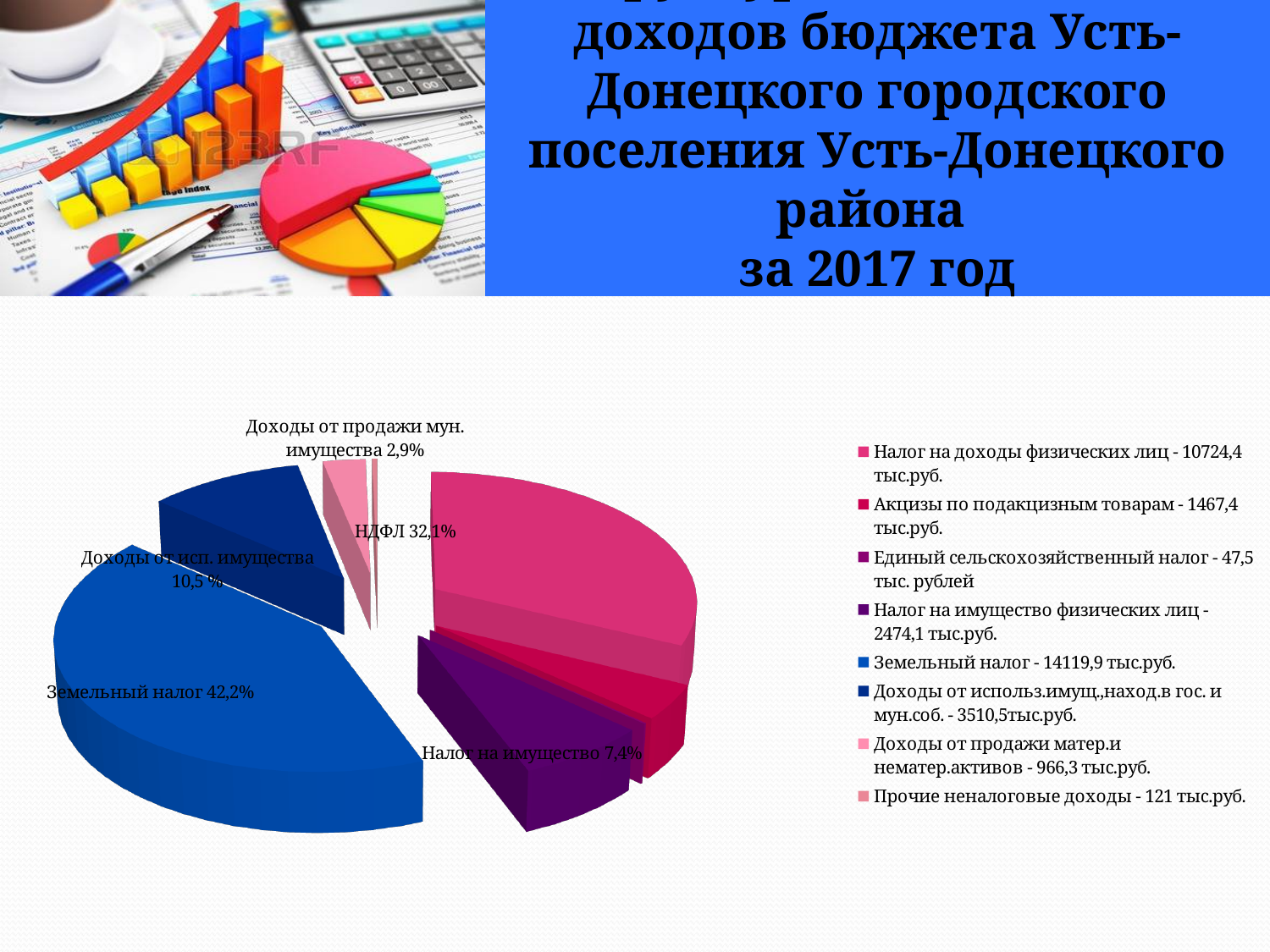
According to the legend, what is the amount for Земельный налог? 14119,9 тыс.руб. What share of the pie does НДФЛ have? 32,1% What type of chart is shown on the slide? pie chart Which is larger: the share for Земельный налог or the share for НДФЛ? Земельный налог Which labelled slice of the pie is the largest? Земельный налог According to the legend, what is the amount for Налог на доходы физических лиц? 10724,4 тыс.руб. What share of the pie does Земельный налог have? 42,2% What share of the pie does Налог на имущество have? 7,4% How many entries does the legend list? 8 What is the difference in percentage points between the Земельный налог share (42,2%) and the НДФЛ share (32,1%)? 10,1 What share of the pie does Доходы от продажи мун. имущества have? 2,9% What share of the pie does Доходы от исп. имущества have? 10,5 %